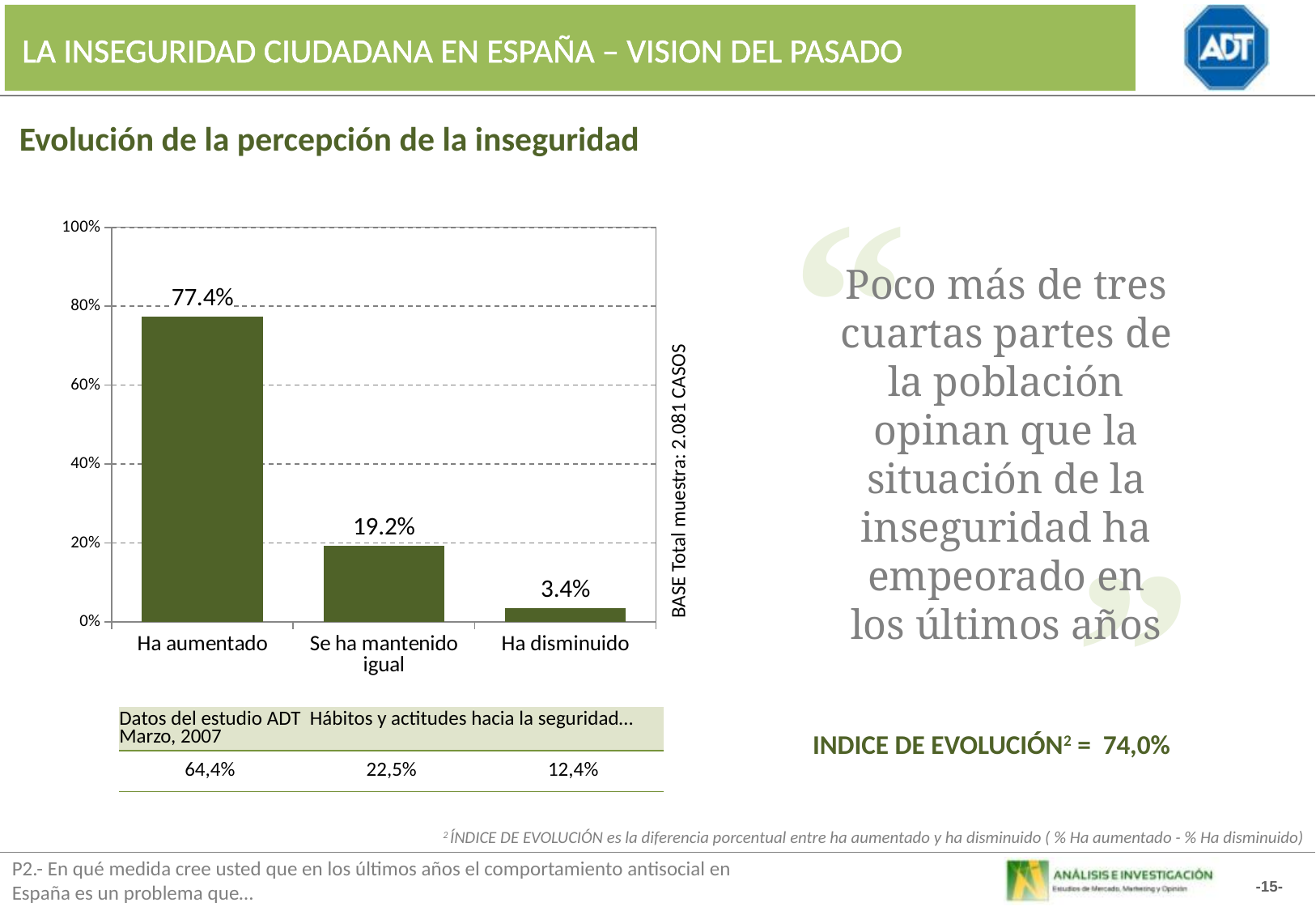
How many categories are shown in the chart? 3 Which category has the highest value? Ha aumentado Which category has the lowest value? Ha disminuido Is the value for 'Ha aumentado' greater or less than 60%? greater What is the value for 'Ha disminuido'? 3.4% Which is larger, the value for 'Se ha mantenido igual' or 'Ha disminuido'? Se ha mantenido igual Do the values rise or fall from left to right across the categories? fall What is the difference between the values for 'Ha aumentado' and 'Ha disminuido'? 74.0% What is the value for 'Ha aumentado'? 77.4% What is the difference between the values for 'Ha aumentado' and 'Se ha mantenido igual'? 58.2% What kind of chart is shown on the slide? bar chart What is the value for 'Se ha mantenido igual'? 19.2%